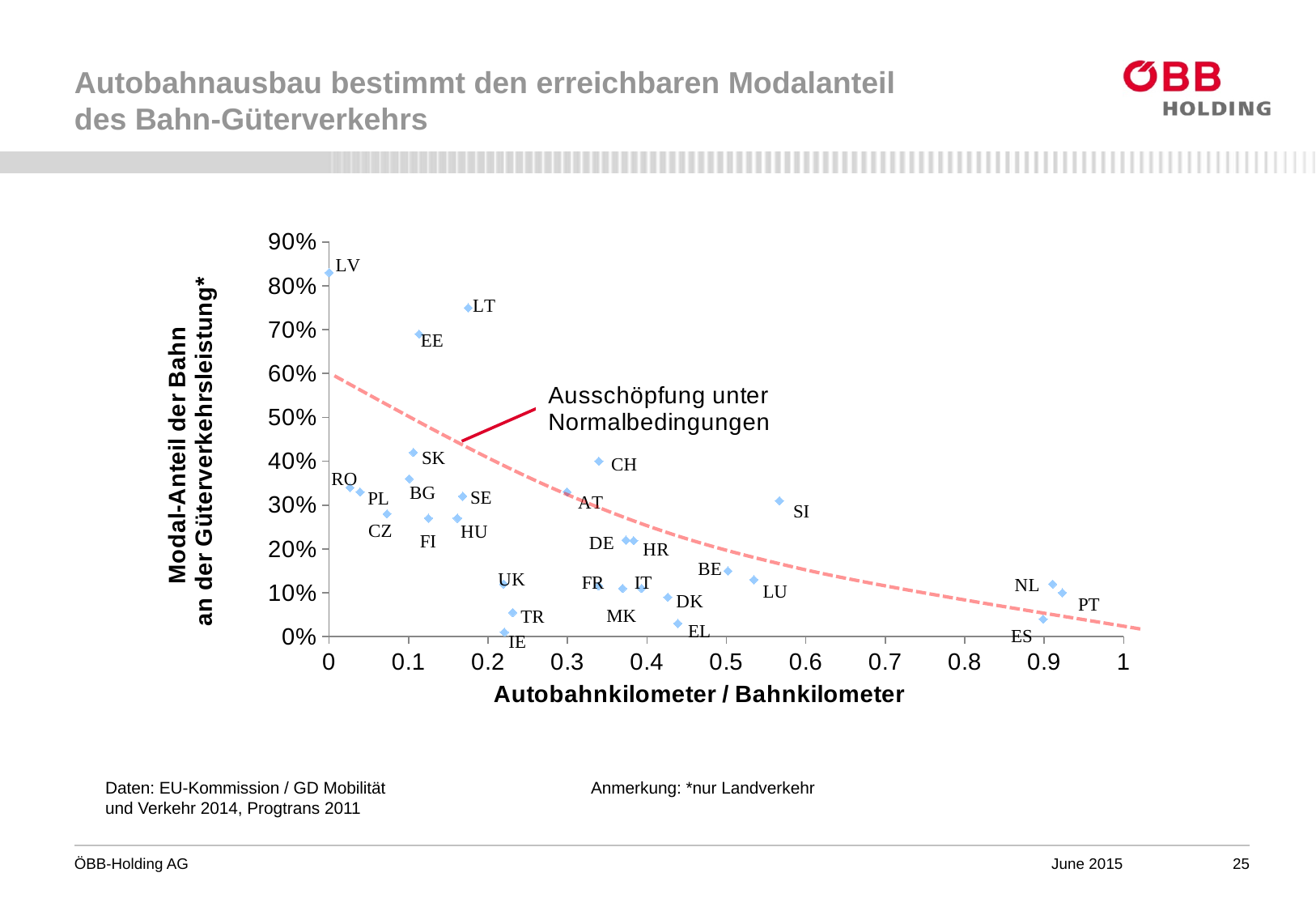
Is the modal share value for DE greater or less than 30%? less Which has a higher modal share of rail, SI or BE? SI Is the modal share value for LT greater or less than 70%? greater Is the modal share value for LV greater or less than 80%? greater What kind of chart is shown on the slide? scatter chart Which country has the lowest modal share of rail in freight transport? IE Which country has the highest modal share of rail in freight transport? LV What is the label of the x axis? Autobahnkilometer / Bahnkilometer Which has a higher modal share of rail, LT or EE? LT What does the annotation pointing to the dashed curve say? Ausschöpfung unter Normalbedingungen